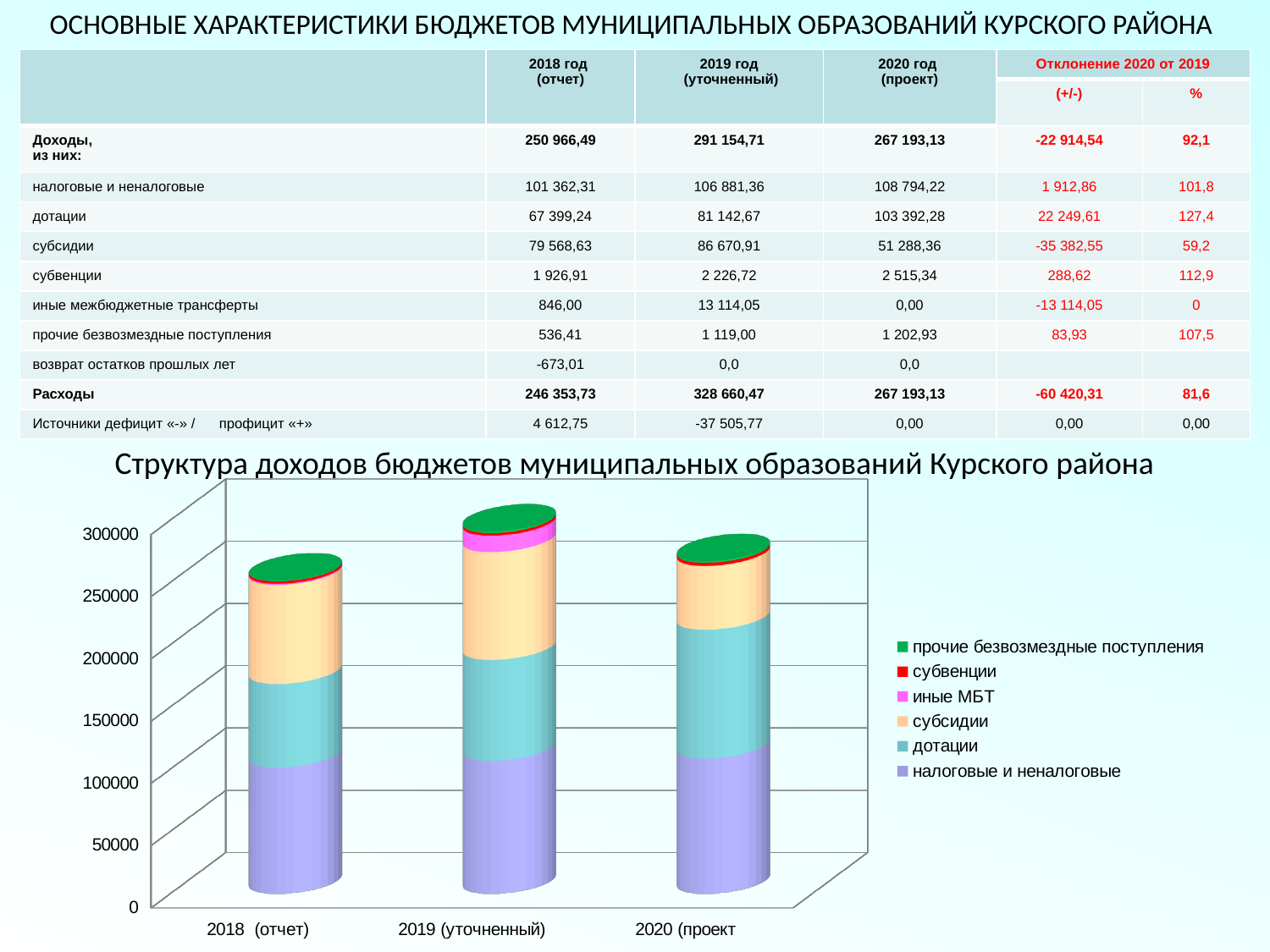
How many series does the legend of the chart list? 6 Is the 'налоговые и неналоговые' segment of the 2018 (отчет) bar greater or less than 50000? greater What kind of chart is shown under the title 'Структура доходов бюджетов муниципальных образований Курского района'? stacked bar chart How many categories (years) are shown on the x axis of the chart? 3 Is the total stacked bar for 2019 (уточненный) taller or shorter than the bar for 2018 (отчет)? taller Which series is shown at the bottom of each stacked bar in the chart? налоговые и неналоговые Which year has the tallest stacked bar in the chart? 2019 (уточненный) Is the total height of the 2020 (проект) bar greater or less than 200000? greater Which year's bar is the only one with a visible pink 'иные МБТ' segment? 2019 (уточненный) Which year has the shortest stacked bar in the chart? 2018 (отчет) Does the total height of the bars rise or fall from 2019 (уточненный) to 2020 (проект)? fall Is the total height of the 2019 (уточненный) bar greater or less than 250000? greater